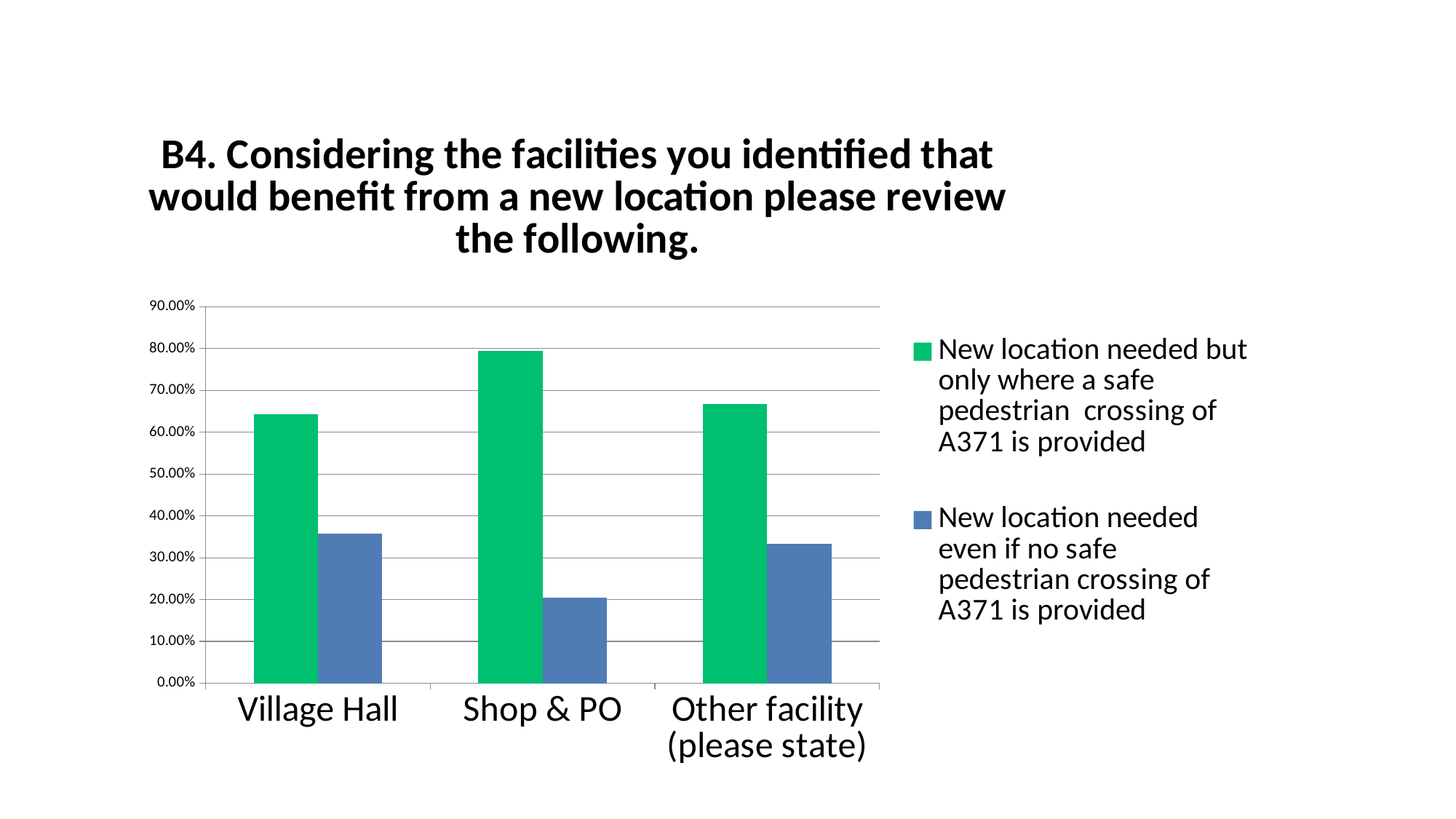
How many series does the chart's legend list? 2 What type of chart is shown on the slide? Bar chart How many categories are shown on the x axis of the chart? 3 Is the value for Village Hall in the 'New location needed but only where a safe pedestrian crossing of A371 is provided' series greater or less than 60.00%? greater Which category has the highest value for 'New location needed but only where a safe pedestrian crossing of A371 is provided'? Shop & PO Which category has the lowest value for 'New location needed even if no safe pedestrian crossing of A371 is provided'? Shop & PO Is the value for Shop & PO in the 'New location needed but only where a safe pedestrian crossing of A371 is provided' series greater or less than 70.00%? greater Which category has the highest value for 'New location needed even if no safe pedestrian crossing of A371 is provided'? Village Hall For Village Hall, which series has the larger value: 'New location needed but only where a safe pedestrian crossing of A371 is provided' or 'New location needed even if no safe pedestrian crossing of A371 is provided'? New location needed but only where a safe pedestrian crossing of A371 is provided Is the value for Other facility (please state) in the 'New location needed even if no safe pedestrian crossing of A371 is provided' series greater or less than 40.00%? less What colour are the bars for the 'New location needed even if no safe pedestrian crossing of A371 is provided' series? Blue